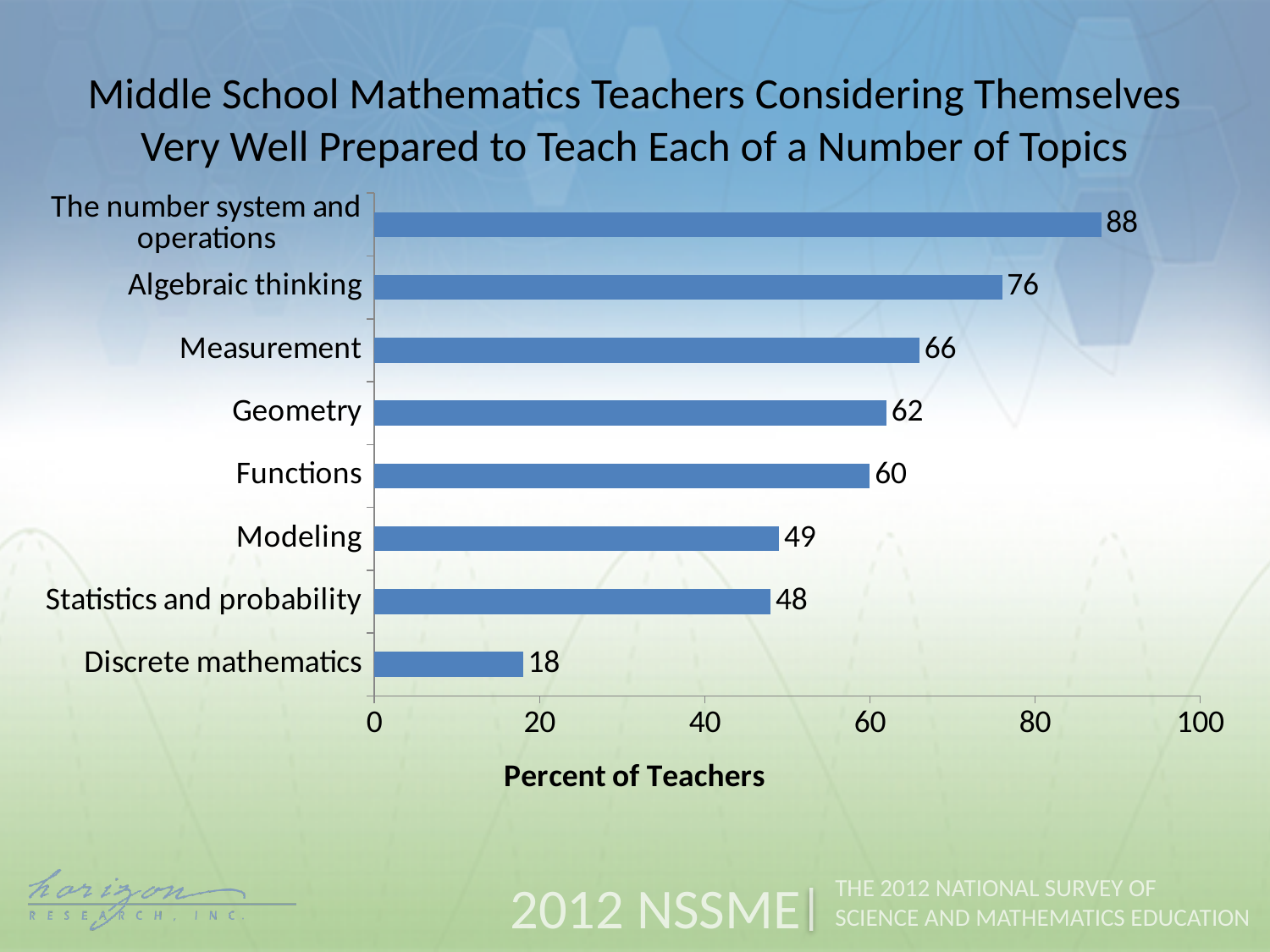
What is the difference between the values for The number system and operations and Discrete mathematics? 70 What percent of middle school mathematics teachers consider themselves very well prepared to teach Algebraic thinking? 76 How many topics are shown in the chart? 8 What is the value shown for Functions? 60 What is the label of the horizontal axis? Percent of Teachers What is the value shown for Discrete mathematics? 18 Which topic has the lowest percent of teachers considering themselves very well prepared? Discrete mathematics Which has a larger value, Modeling or Statistics and probability? Modeling What kind of chart is shown on the slide? Bar chart Is the value for Measurement greater or less than 60? greater Which topic has the highest percent of teachers considering themselves very well prepared? The number system and operations What is the difference between the values for Measurement and Geometry? 4